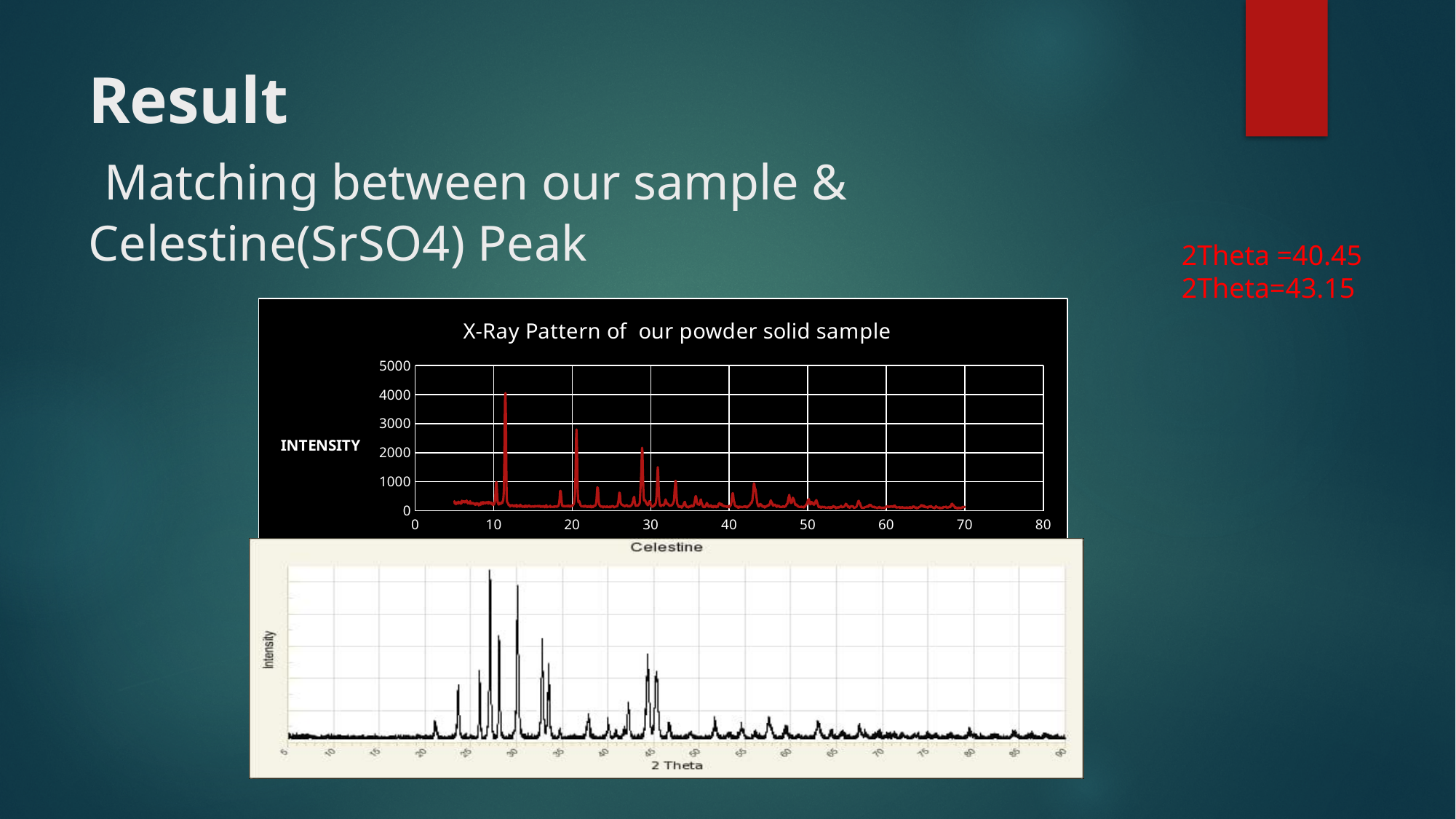
In the top chart 'X-Ray Pattern of our powder solid sample', do the peak intensities generally become smaller or larger as 2Theta increases beyond 35? smaller What is the x-axis label of the bottom chart titled 'Celestine'? 2 Theta In the top chart 'X-Ray Pattern of our powder solid sample', is the peak near 2Theta = 29 greater or less than 3000? less What is the title of the top chart on the slide? X-Ray Pattern of our powder solid sample What kind of chart is the bottom chart titled 'Celestine'? line chart In the top chart 'X-Ray Pattern of our powder solid sample', is the peak near 2Theta = 33 greater or less than 2000? less In the top chart 'X-Ray Pattern of our powder solid sample', is the tallest peak greater or less than 3000? greater In the top chart 'X-Ray Pattern of our powder solid sample', which is taller: the peak near 2Theta = 11 or the peak near 2Theta = 20? the peak near 2Theta = 11 What kind of chart is the top chart titled 'X-Ray Pattern of our powder solid sample'? line chart